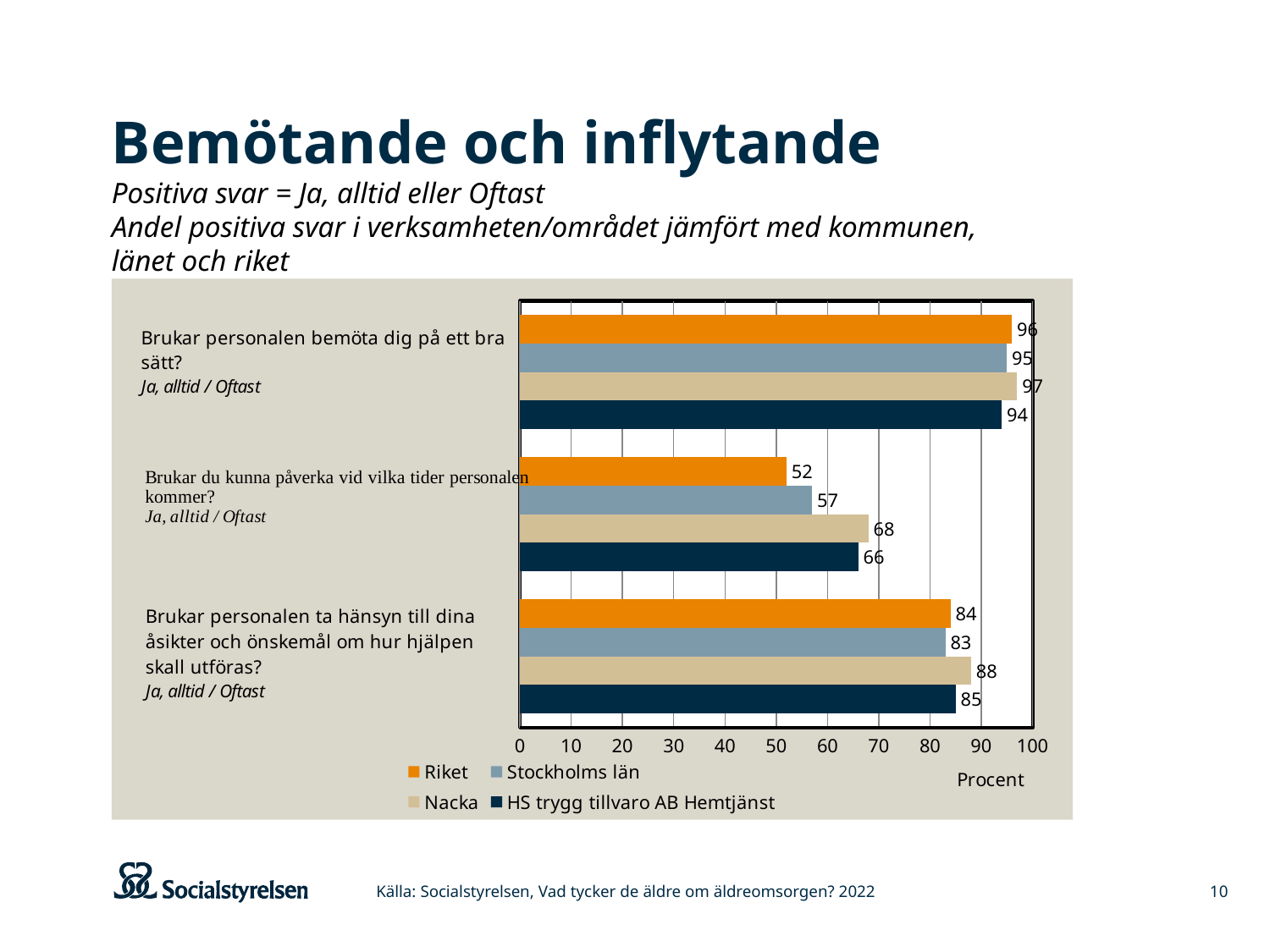
What kind of chart is shown on the slide? bar chart Which series has the lowest value on the question 'Brukar du kunna påverka vid vilka tider personalen kommer?' Riket How many question categories are plotted on the chart? 3 What is the value for HS trygg tillvaro AB Hemtjänst on the question 'Brukar personalen ta hänsyn till dina åsikter och önskemål om hur hjälpen skall utföras?' 85 Which series has the highest value on the question 'Brukar personalen ta hänsyn till dina åsikter och önskemål om hur hjälpen skall utföras?' Nacka What is the value for Stockholms län on the question 'Brukar personalen bemöta dig på ett bra sätt?' 95 How many series does the legend list? 4 What is the difference between Nacka and Riket on the question 'Brukar du kunna påverka vid vilka tider personalen kommer?' 16 What is the value for Nacka on the question 'Brukar du kunna påverka vid vilka tider personalen kommer?' 68 What is the value for Riket on the question 'Brukar du kunna påverka vid vilka tider personalen kommer?' 52 What is the label on the horizontal axis of the chart? Procent On the question 'Brukar du kunna påverka vid vilka tider personalen kommer?', which is larger: Stockholms län or HS trygg tillvaro AB Hemtjänst? HS trygg tillvaro AB Hemtjänst